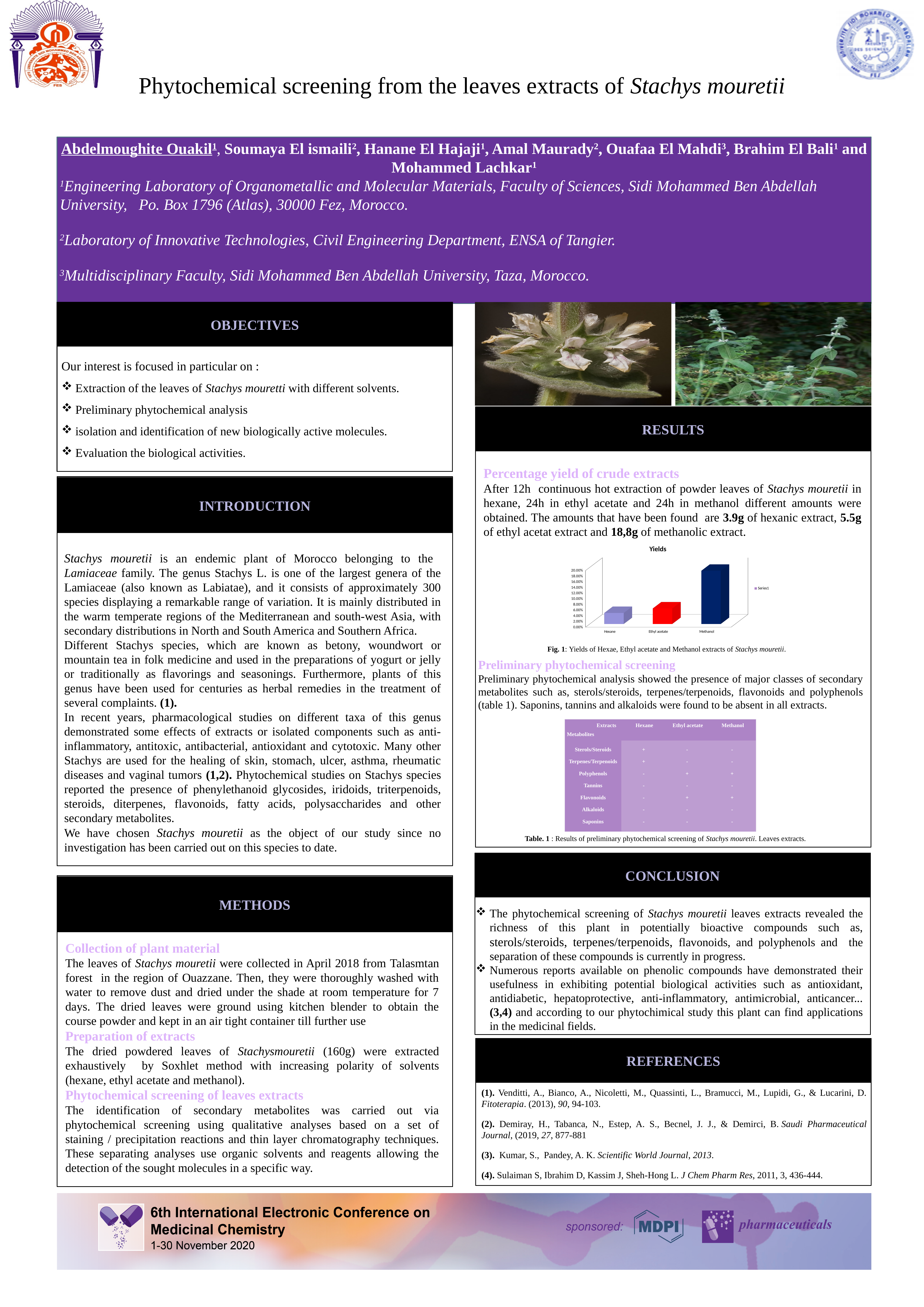
In the Yields chart, is the value for Methanol greater or less than 10.00%? greater In the Yields chart, is the value for Ethyl acetate greater or less than 8.00%? less In the Yields chart, is the value for Hexane greater or less than 6.00%? less What is the legend entry shown on the Yields chart? Series1 What type of chart is shown in Fig. 1 under Results? bar chart How many categories are plotted on the x axis of the Yields chart? 3 What is the title of the chart in Fig. 1? Yields In the Yields chart, which is larger, the bar for Methanol or the bar for Ethyl acetate? Methanol Which category has the highest bar in the Yields chart? Methanol Do the bars in the Yields chart rise or fall from left to right along the x axis? rise Which category has the lowest bar in the Yields chart? Hexane How many series does the legend of the Yields chart list? 1